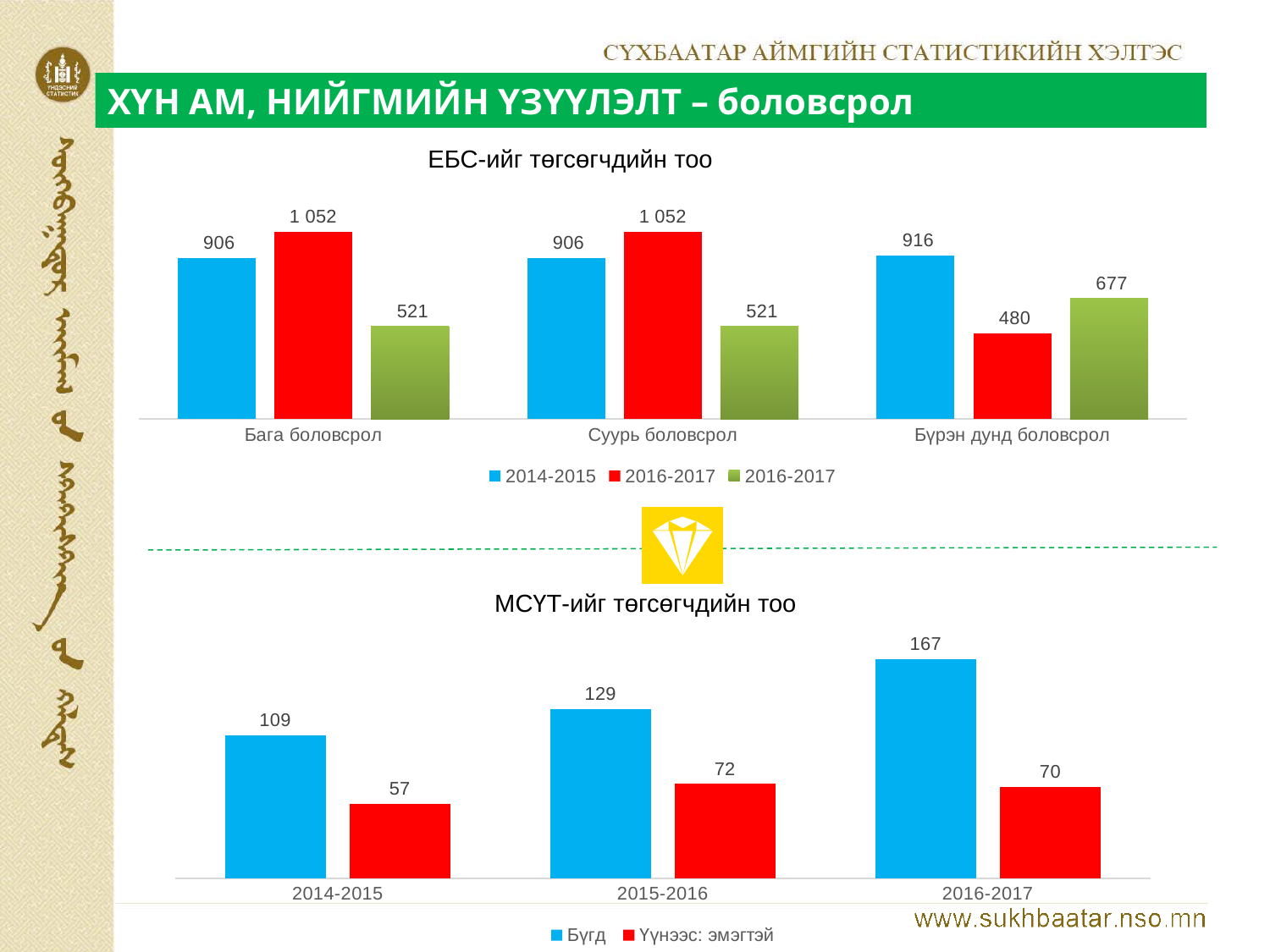
In the chart titled 'ЕБС-ийг төгсөгчдийн тоо', what is the value of the blue (2014-2015) bar for Бүрэн дунд боловсрол? 916 What kind of chart is the chart titled 'МСҮТ-ийг төгсөгчдийн тоо'? bar chart In the chart titled 'ЕБС-ийг төгсөгчдийн тоо', how many categories are shown on the x axis? 3 In the chart titled 'МСҮТ-ийг төгсөгчдийн тоо', what is the value of Бүгд for 2016-2017? 167 In the chart titled 'ЕБС-ийг төгсөгчдийн тоо', what is the value of the red bar for Бүрэн дунд боловсрол? 480 In the chart titled 'МСҮТ-ийг төгсөгчдийн тоо', what is the value of 'Үүнээс: эмэгтэй' for 2015-2016? 72 In the chart titled 'ЕБС-ийг төгсөгчдийн тоо', what is the difference between the red bar and the blue bar for Бага боловсрол? 146 In the chart titled 'ЕБС-ийг төгсөгчдийн тоо', how many series does the legend list? 3 In the chart titled 'ЕБС-ийг төгсөгчдийн тоо', what is the value of the green bar for Бага боловсрол? 521 In the chart titled 'МСҮТ-ийг төгсөгчдийн тоо', which year has the lowest value for 'Үүнээс: эмэгтэй'? 2014-2015 In the chart titled 'МСҮТ-ийг төгсөгчдийн тоо', does the Бүгд series rise or fall from 2014-2015 to 2016-2017? rise In the chart titled 'ЕБС-ийг төгсөгчдийн тоо', which category has the highest green bar? Бүрэн дунд боловсрол